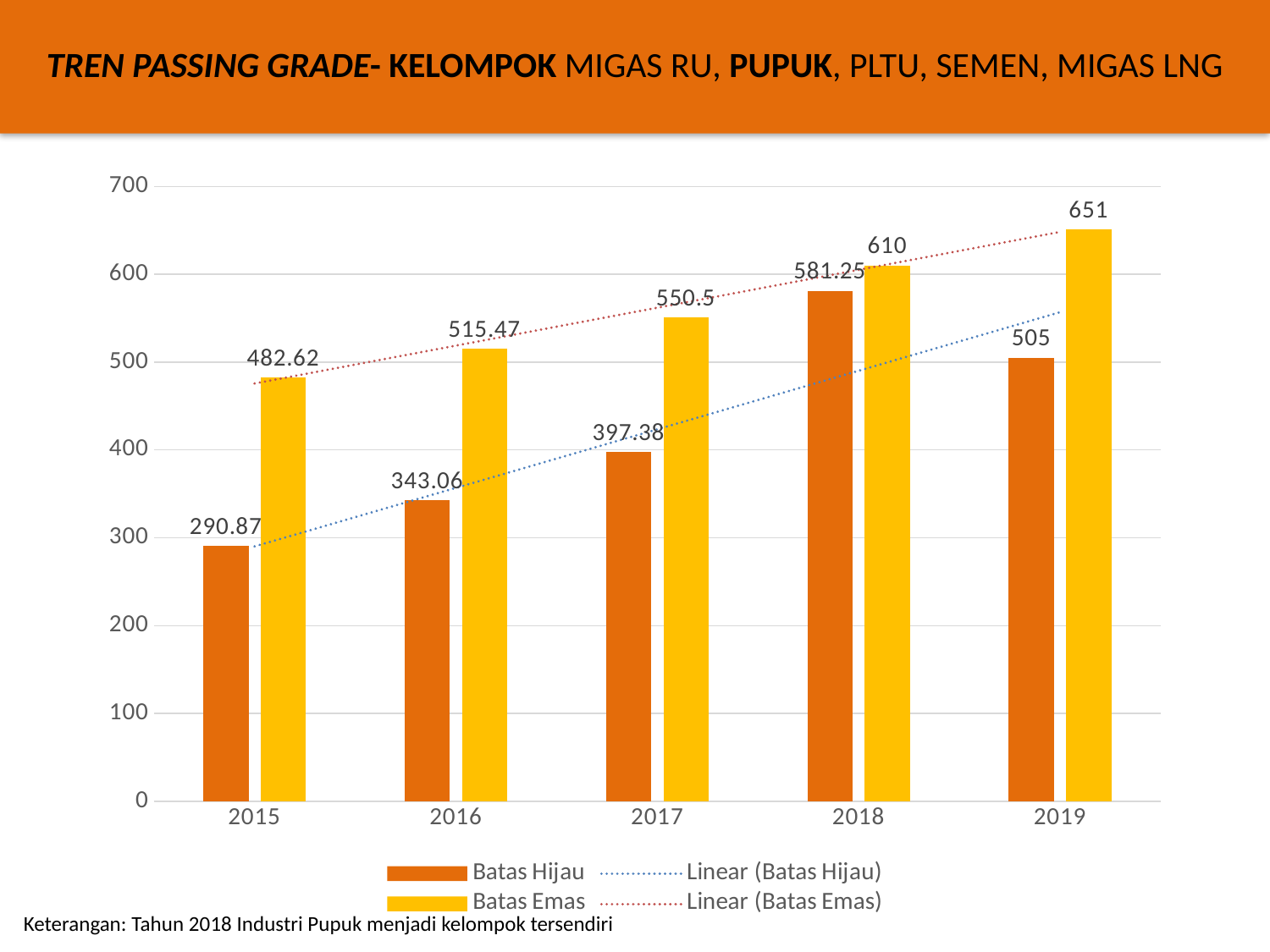
What kind of chart is shown on the slide? Bar chart How many years are shown on the x axis? 5 What is the Batas Hijau value for 2015? 290.87 What is the difference between the Batas Emas and Batas Hijau values in 2019? 146 What is the Batas Hijau value for 2018? 581.25 Do the Batas Emas values rise or fall from 2015 to 2019? Rise What is the difference between the Batas Emas and Batas Hijau values in 2018? 28.75 What is the Batas Emas value for 2016? 515.47 Which year has the highest Batas Emas value? 2019 Which year has the lowest Batas Hijau value? 2015 Which is larger, the Batas Hijau value for 2018 or the Batas Hijau value for 2019? 2018 How many entries does the legend list? 4